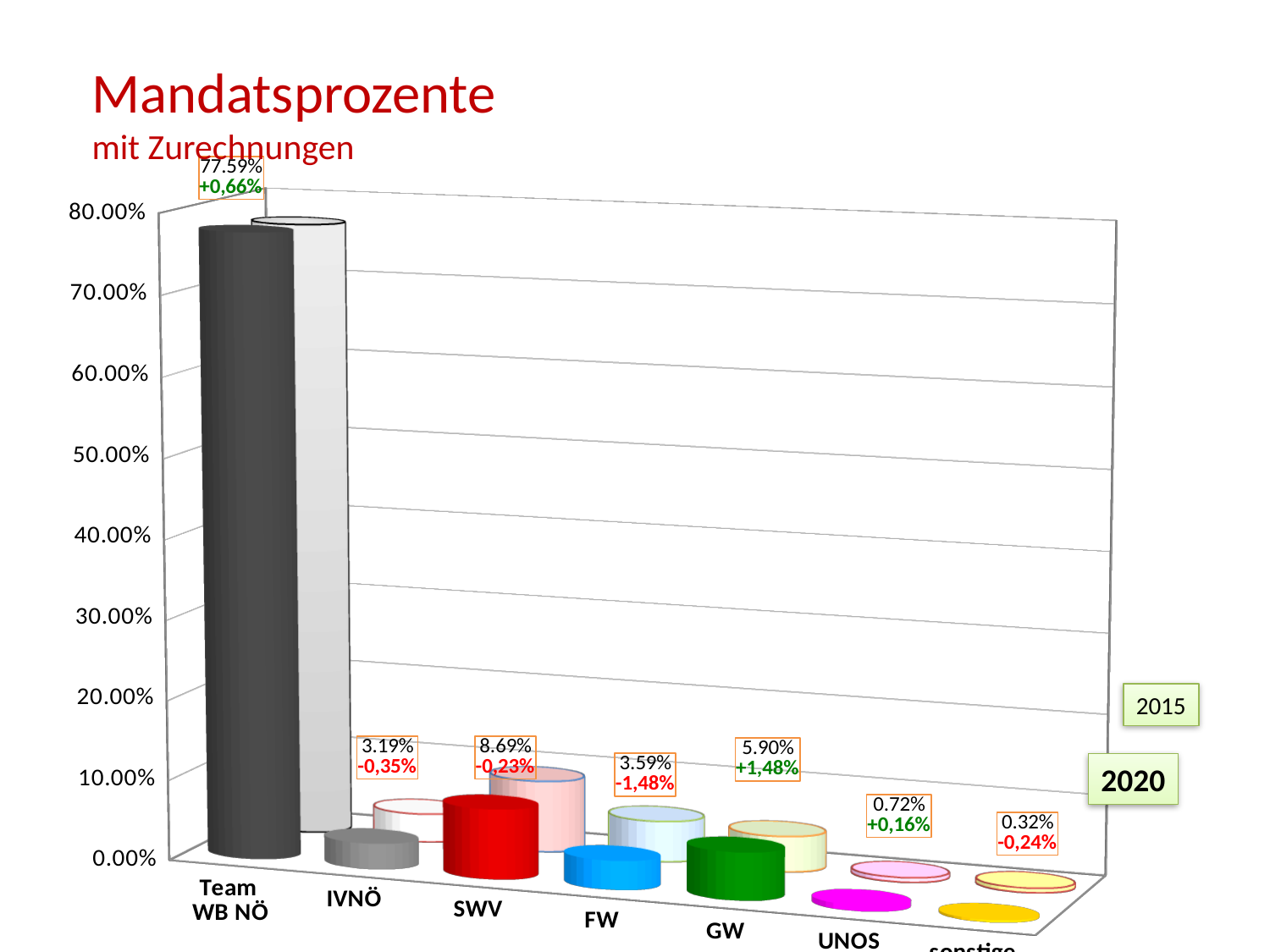
What change value is printed for FW? -1,48% What percentage value is printed above the bars for Team WB NÖ? 77.59% How many categories are shown on the x axis? 7 What percentage value is printed above the bars for SWV? 8.69% What percentage value is printed above the bars for GW? 5.90% How many series does the legend list? 2 Which category has the highest value? Team WB NÖ What is the title of the chart? Mandatsprozente mit Zurechnungen Which category has the lowest printed percentage value? sonstige Which has the larger printed percentage value, SWV or GW? SWV What is the difference between the printed percentage values for SWV and IVNÖ? 5.50% What kind of chart is shown on the slide? bar chart